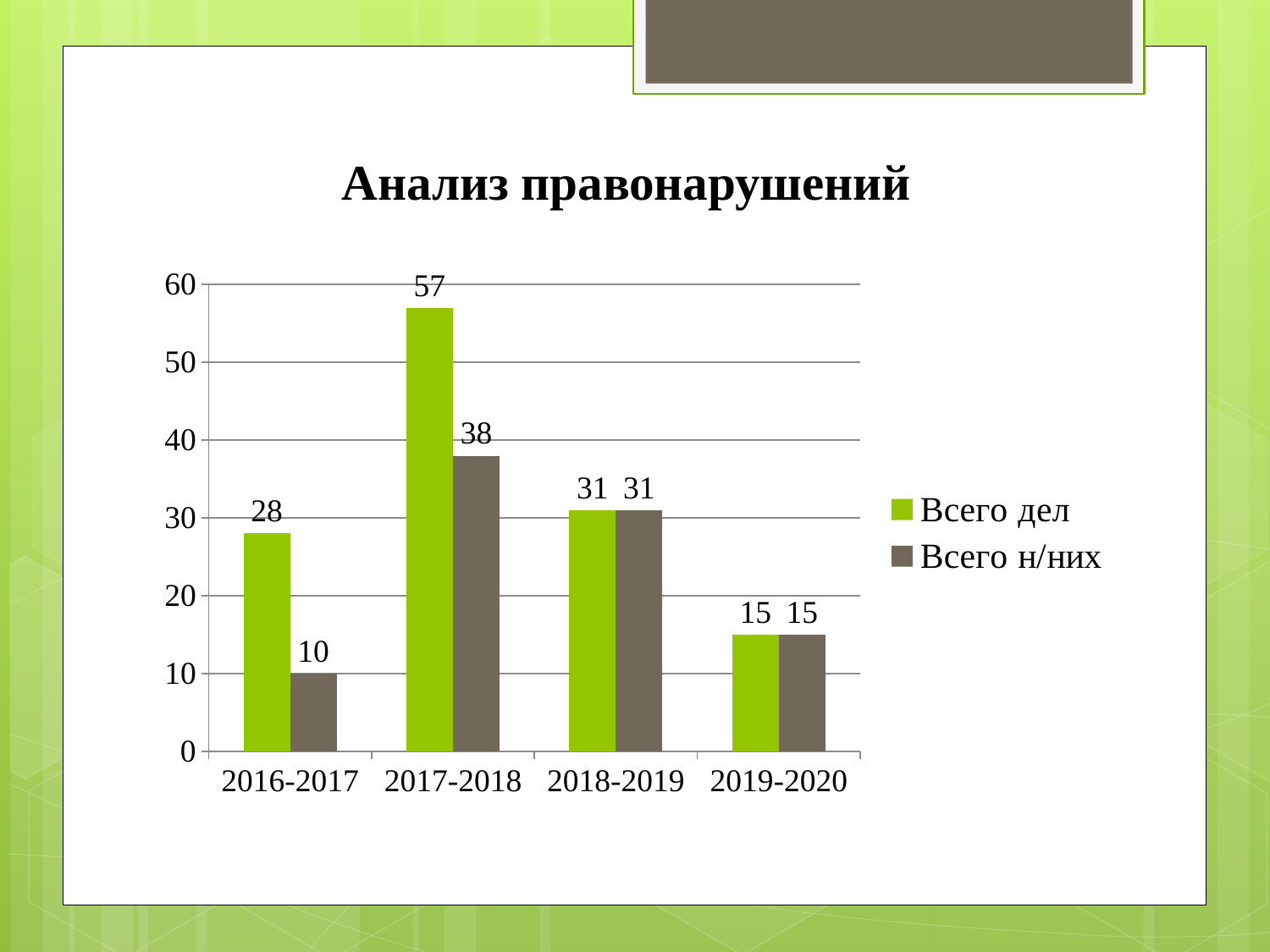
How many periods are shown on the x axis? 4 Which is larger: "Всего дел" in 2016-2017 or "Всего н/них" in 2017-2018? Всего н/них in 2017-2018 What is the difference between "Всего дел" in 2016-2017 and in 2019-2020? 13 What is the difference between "Всего дел" and "Всего н/них" in 2017-2018? 19 What kind of chart is shown on the slide? Bar chart What is the value of "Всего н/них" for 2016-2017? 10 What is the value of "Всего н/них" for 2019-2020? 15 Which period has the lowest value for "Всего н/них"? 2016-2017 How many series does the legend list? 2 What is the value of "Всего дел" for 2017-2018? 57 What is the title of the chart? Анализ правонарушений Which period has the highest value for "Всего дел"? 2017-2018